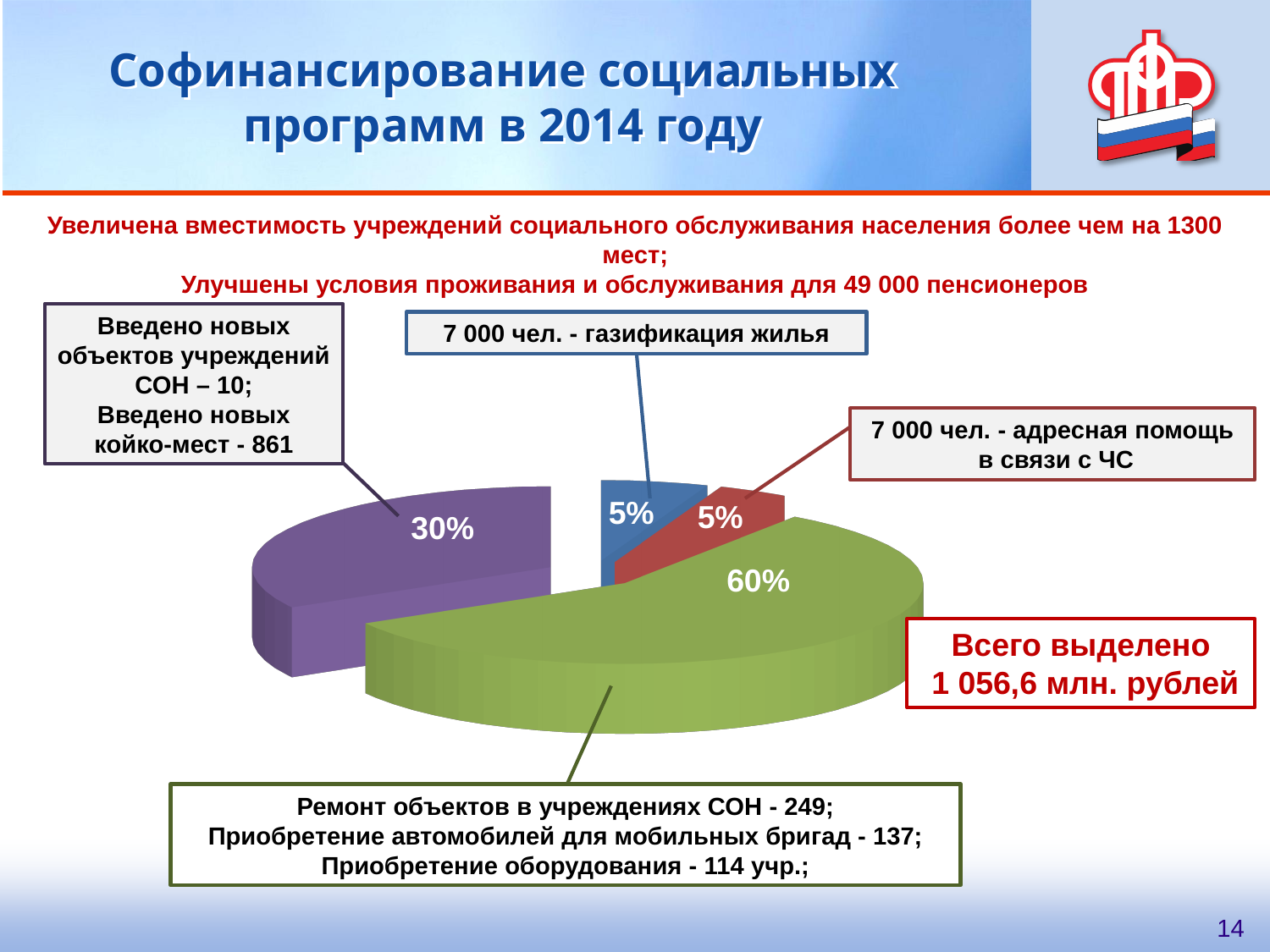
What share of the pie does the red slice (адресная помощь в связи с ЧС) represent? 5% What total amount of funding is stated in the red box next to the pie chart? 1 056,6 млн. рублей How many slices does the pie chart have? 4 What is the difference in percentage points between the green slice (60%) and the purple slice (30%)? 30 Which is larger: the purple slice or the blue slice? the purple slice (30%) What share of the pie does the blue slice (газификация жилья) represent? 5% What is the smallest percentage shown on the pie chart? 5% What share of the pie does the purple slice (Введено новых объектов учреждений СОН) represent? 30% What colour is the slice labelled 30%? purple What kind of chart is shown on the slide? pie chart Which slice of the pie chart is the largest? 60% (green, Ремонт объектов в учреждениях СОН)